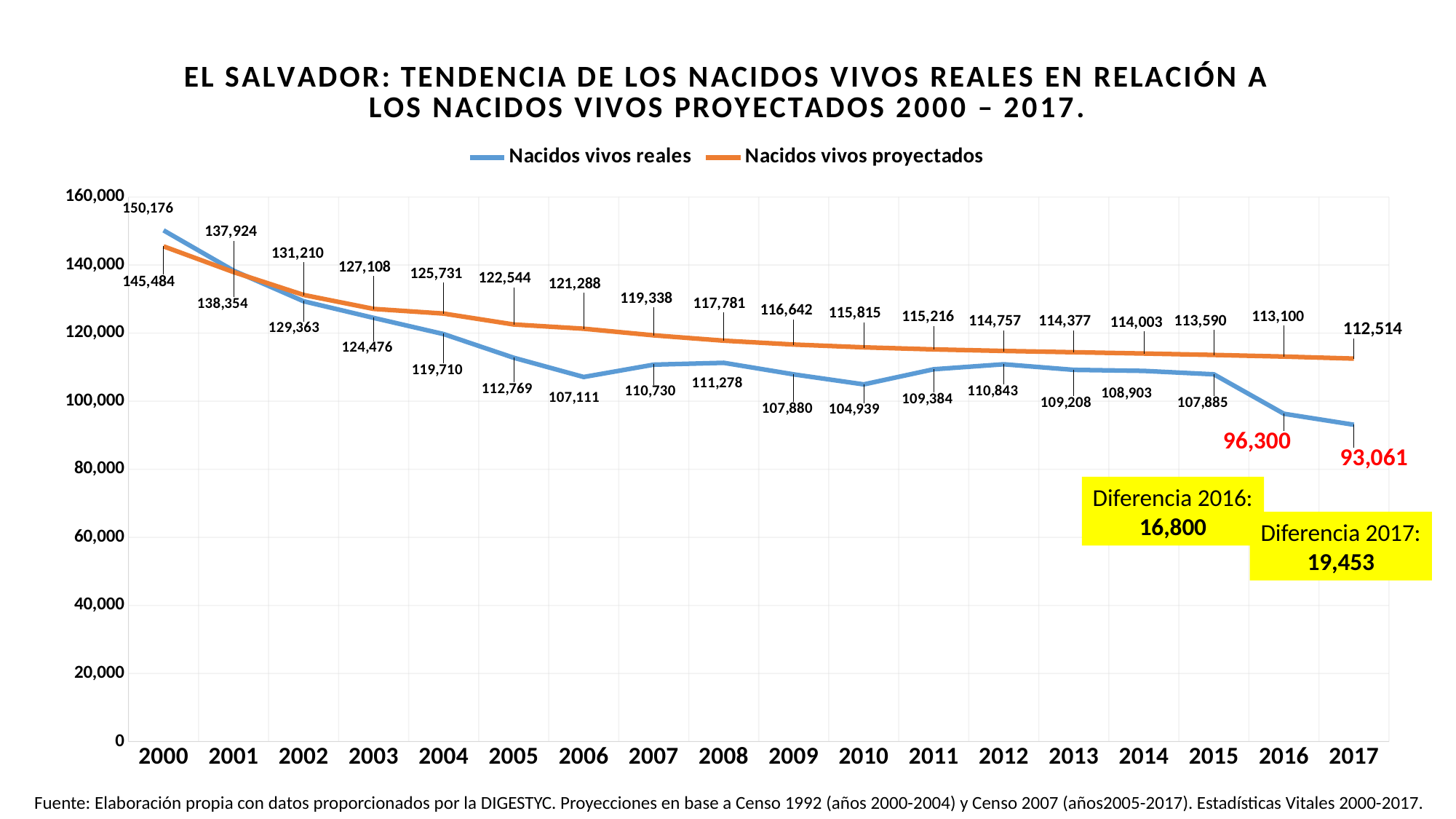
Does the Nacidos vivos proyectados series rise or fall from 2000 to 2017? Fall In 2005, which series has the larger value, Nacidos vivos reales or Nacidos vivos proyectados? Nacidos vivos proyectados How many series does the legend list? 2 What is the difference between Nacidos vivos proyectados and Nacidos vivos reales in 2016? 16,800 In which year is Nacidos vivos reales lowest? 2017 How many years are plotted along the x axis? 18 What kind of chart is shown on the slide? Line chart What is the value of Nacidos vivos proyectados in 2010? 115,815 What is the value of Nacidos vivos reales in 2010? 104,939 What is the value of Nacidos vivos reales in 2017? 93,061 In which year is Nacidos vivos reales highest? 2000 What colour is the Nacidos vivos reales line? Blue